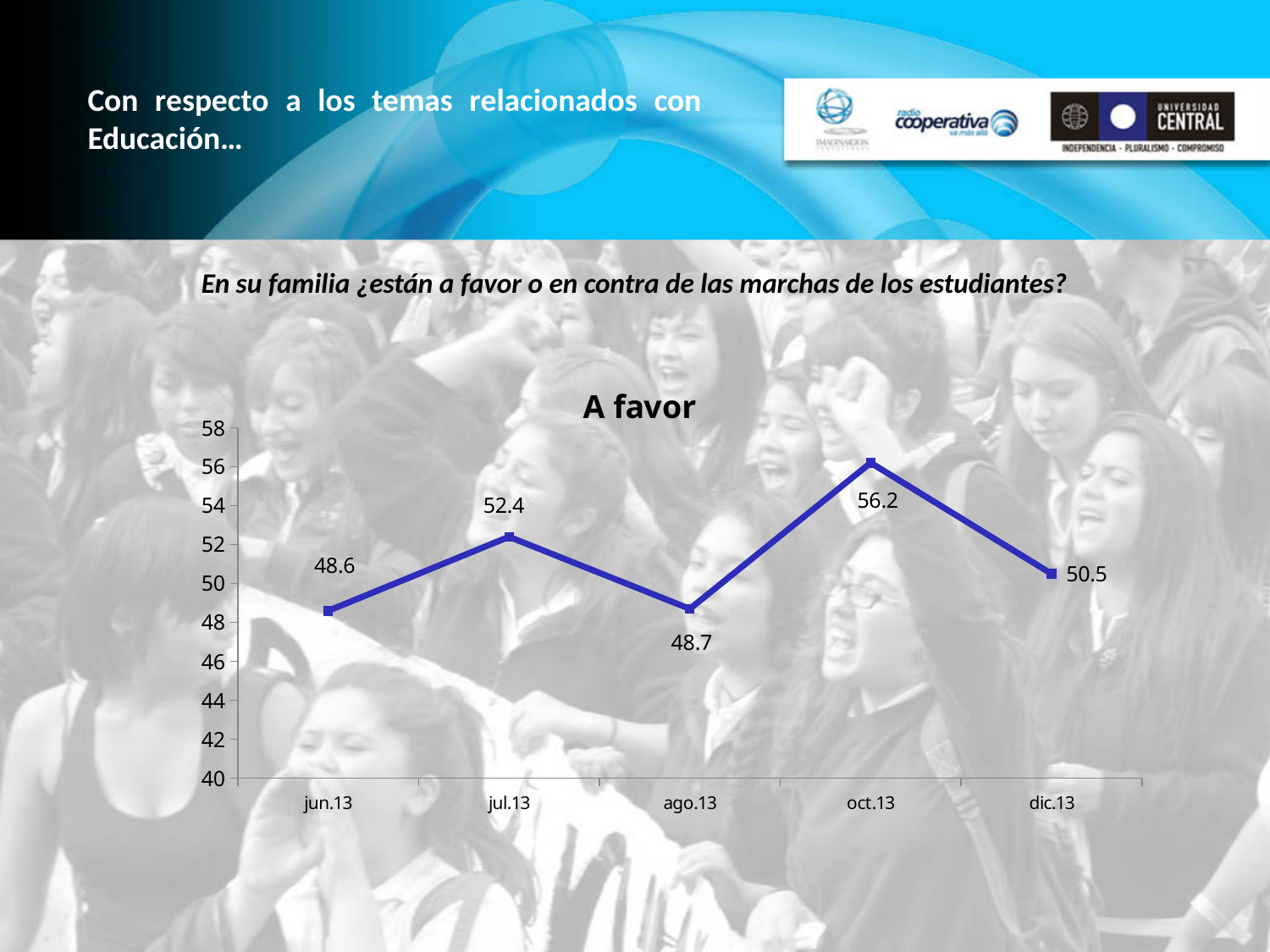
What is the difference between the values for oct.13 and dic.13? 5.7 What is the value for jun.13? 48.6 Which is larger, the value for jul.13 or the value for ago.13? jul.13 What kind of chart is shown? line chart Which month has the lowest value? jun.13 How many months are plotted on the chart? 5 What is the value for oct.13? 56.2 What is the value for dic.13? 50.5 Which month has the highest value? oct.13 Is the value for oct.13 greater or less than 54? greater What is the difference between the values for jul.13 and jun.13? 3.8 What is the title of the chart? A favor